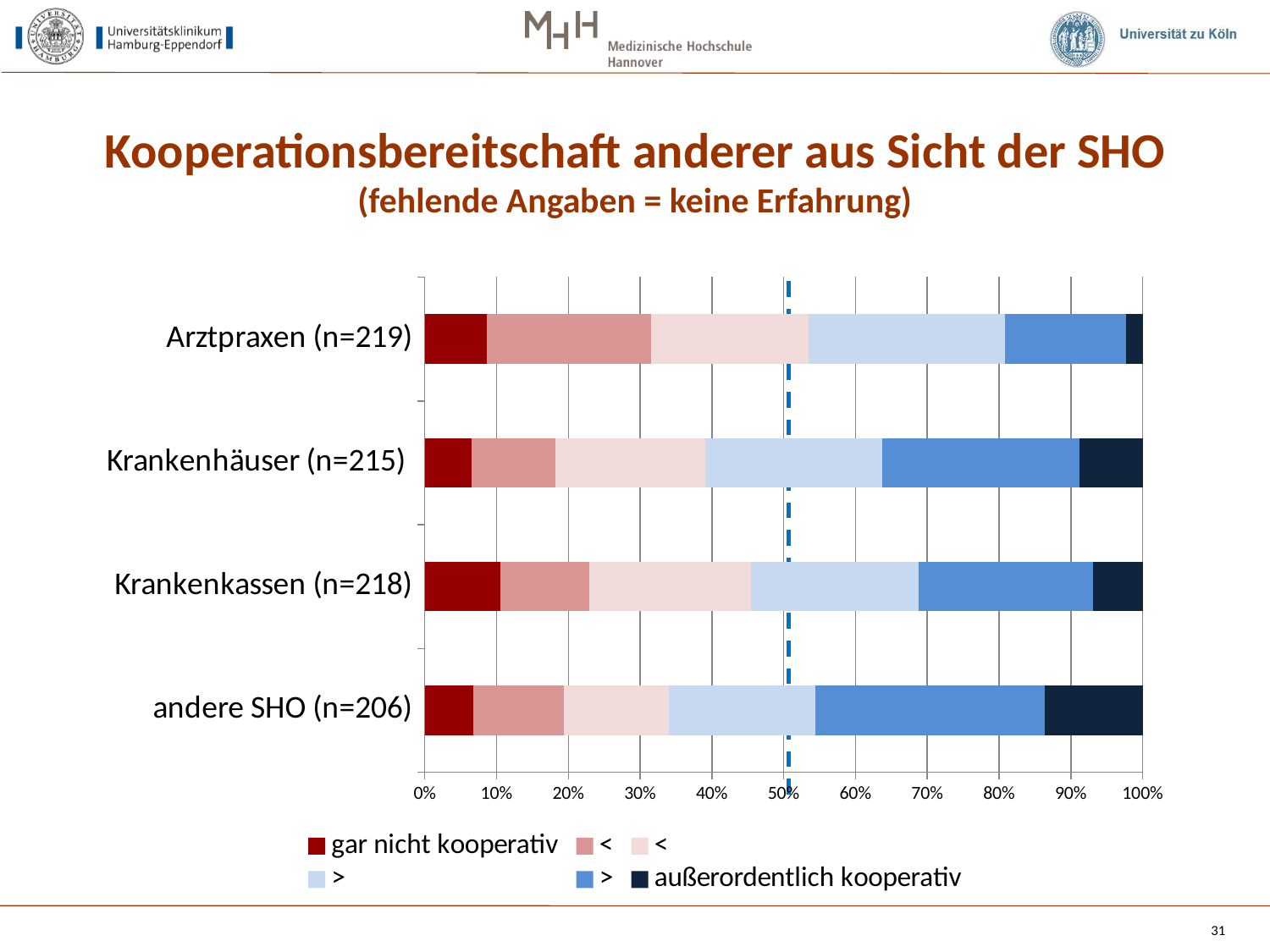
Which category has the largest 'außerordentlich kooperativ' (dark blue) segment? andere SHO (n=206) What is the sample size (n) given for Krankenhäuser? 215 What is the title of the chart on the slide? Kooperationsbereitschaft anderer aus Sicht der SHO What kind of chart is shown on the slide? stacked bar chart Is the combined share of the three red (less cooperative) segments for Arztpraxen greater or less than 50%? greater Is the 'gar nicht kooperativ' value for Krankenhäuser greater or less than 10%? less Is the 'gar nicht kooperativ' segment larger for Krankenkassen or for Krankenhäuser? Krankenkassen How many categories (groups) are plotted on the chart? 4 Which category has the smallest 'außerordentlich kooperativ' (dark blue) segment? Arztpraxen (n=219) How many series does the legend list? 6 What is the first entry in the chart legend? gar nicht kooperativ What is the sample size (n) given for andere SHO? 206